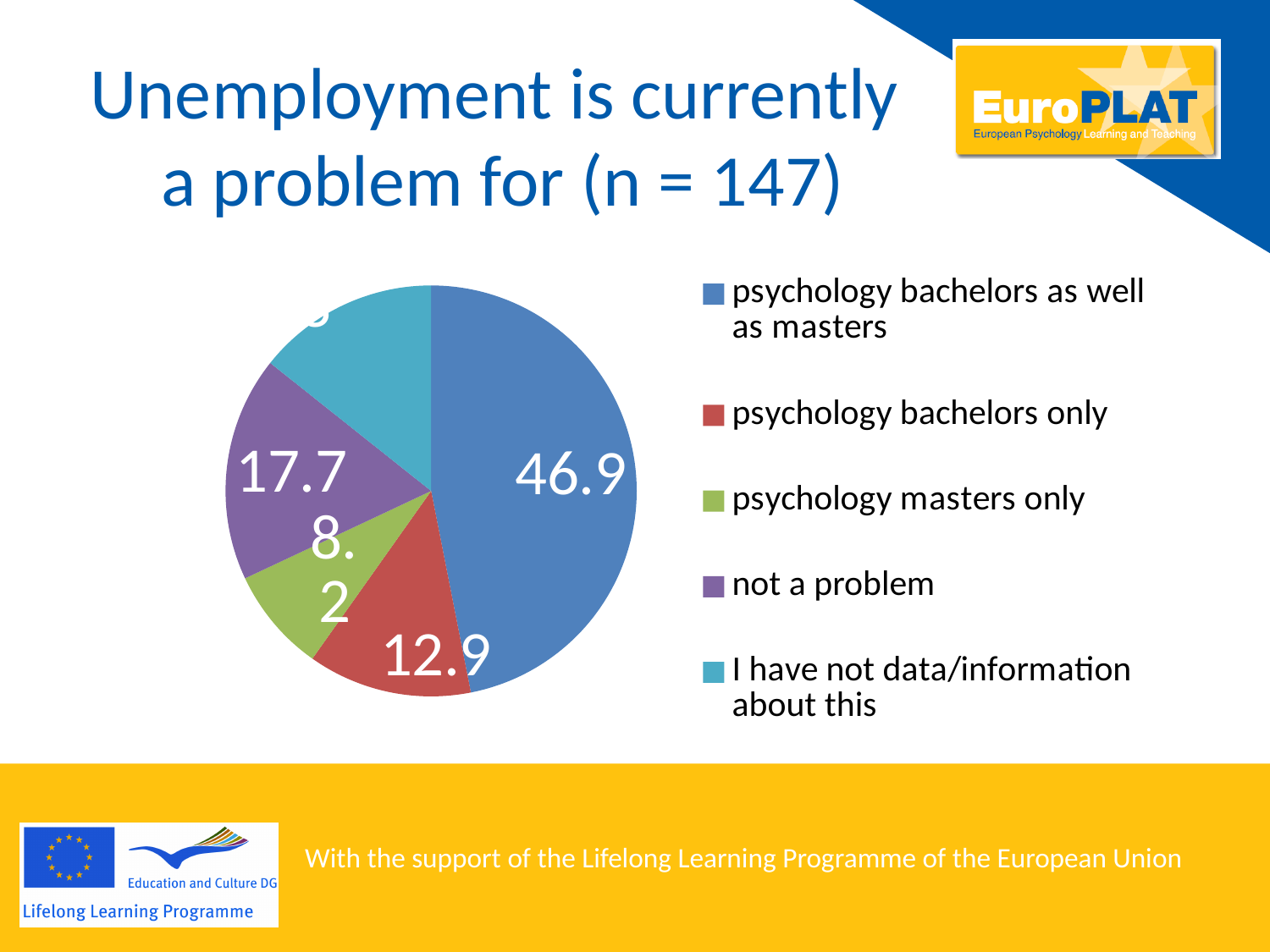
What is the value for 'not a problem'? 17.7 What kind of chart is shown on the slide? pie chart What is the difference between the values for 'not a problem' and 'psychology bachelors only'? 4.8 What is the value for 'psychology bachelors only'? 12.9 What is the value for 'psychology masters only'? 8.2 What is the value for 'psychology bachelors as well as masters'? 46.9 How many categories does the legend list? 5 What is the title of the slide containing the chart? Unemployment is currently a problem for (n = 147) Which category has the largest slice of the pie? psychology bachelors as well as masters Which category has the smallest slice of the pie? psychology masters only What is the difference between the values for 'psychology bachelors as well as masters' and 'psychology bachelors only'? 34.0 Which is larger: the value for 'not a problem' or the value for 'psychology masters only'? not a problem